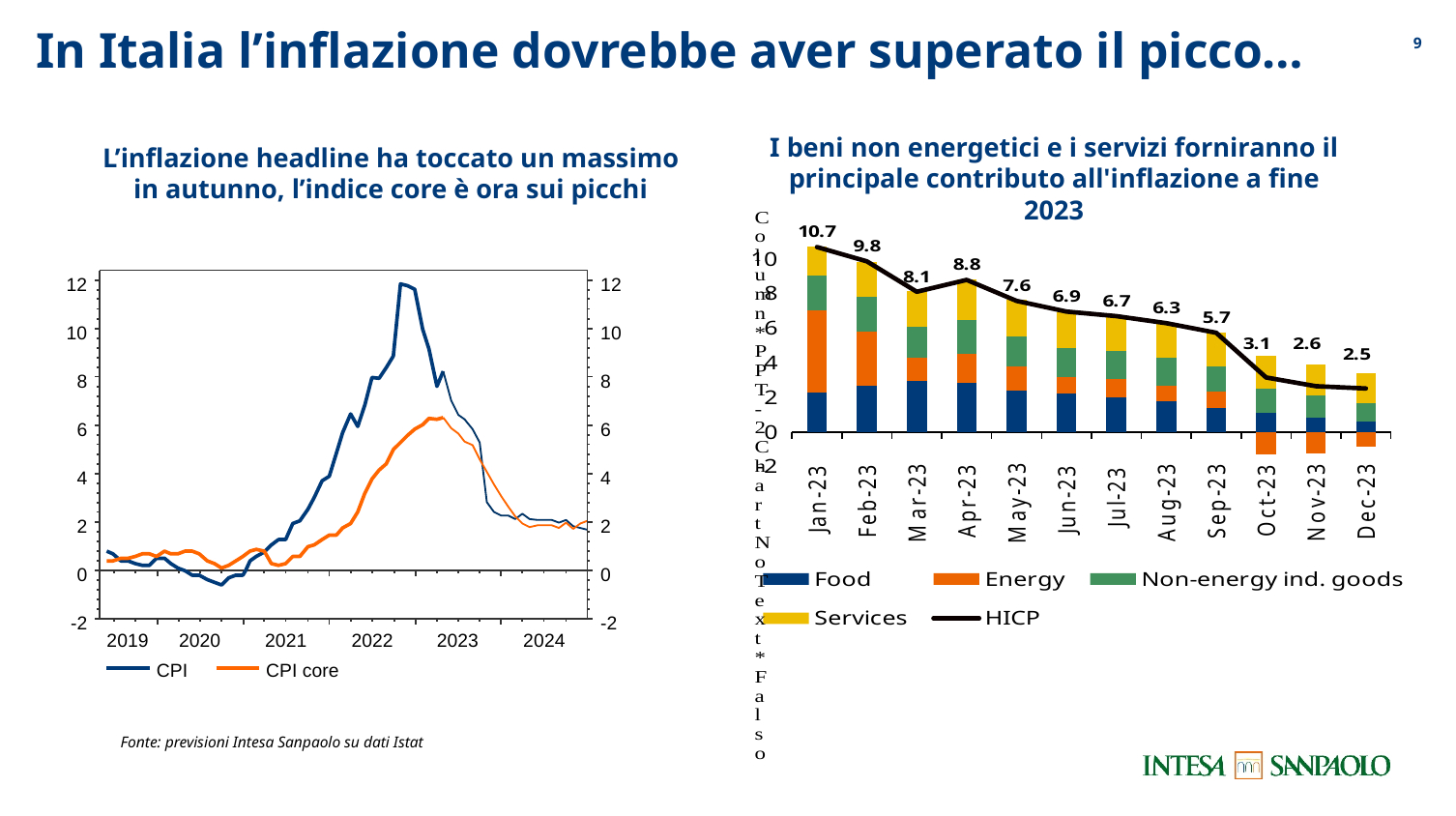
In the right chart, what is the HICP value for Dec-23? 2.5 In the left chart, is the peak value of the CPI line greater or less than 10? greater In the right chart (I beni non energetici e i servizi...), what is the HICP value for Jan-23? 10.7 In the right chart, what is the difference between the HICP value for Jan-23 and Dec-23? 8.2 In the right chart, which month has the highest HICP value? Jan-23 In the right chart, which month has a higher HICP value, Mar-23 or Apr-23? Apr-23 In the right chart, what is the HICP value for Sep-23? 5.7 In the right chart, does the HICP line rise or fall from Jan-23 to Dec-23? Fall What kind of chart is the left chart (L'inflazione headline ha toccato un massimo...)? Line chart How many series does the legend of the right chart list? 5 How many months are shown on the x axis of the right chart? 12 In the right chart, which month has the lowest HICP value? Dec-23